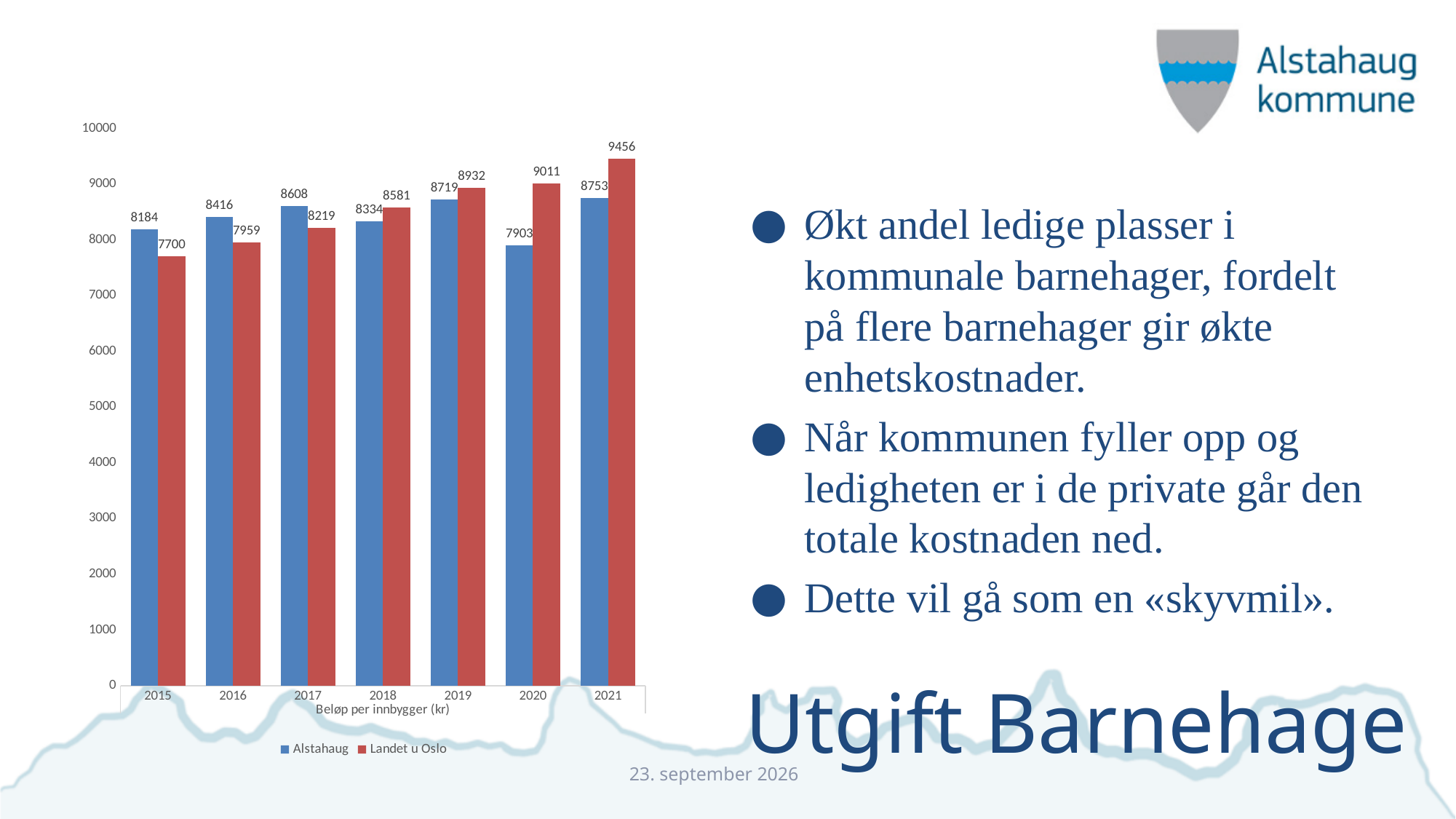
What is the difference between Landet u Oslo and Alstahaug in 2020? 1108 In which year is the Landet u Oslo value highest? 2021 In 2018, which series has the larger value, Alstahaug or Landet u Oslo? Landet u Oslo What is the difference between Landet u Oslo and Alstahaug in 2021? 703 How many years are shown on the x axis? 7 In which year is the Alstahaug value lowest? 2020 What is the value for Alstahaug in 2020? 7903 What is the value for Landet u Oslo in 2021? 9456 What is the value for Alstahaug in 2015? 8184 Is the value for Landet u Oslo in 2015 greater or less than 8000? less Do the Landet u Oslo values generally rise or fall from 2015 to 2021? rise How many series does the legend list? 2